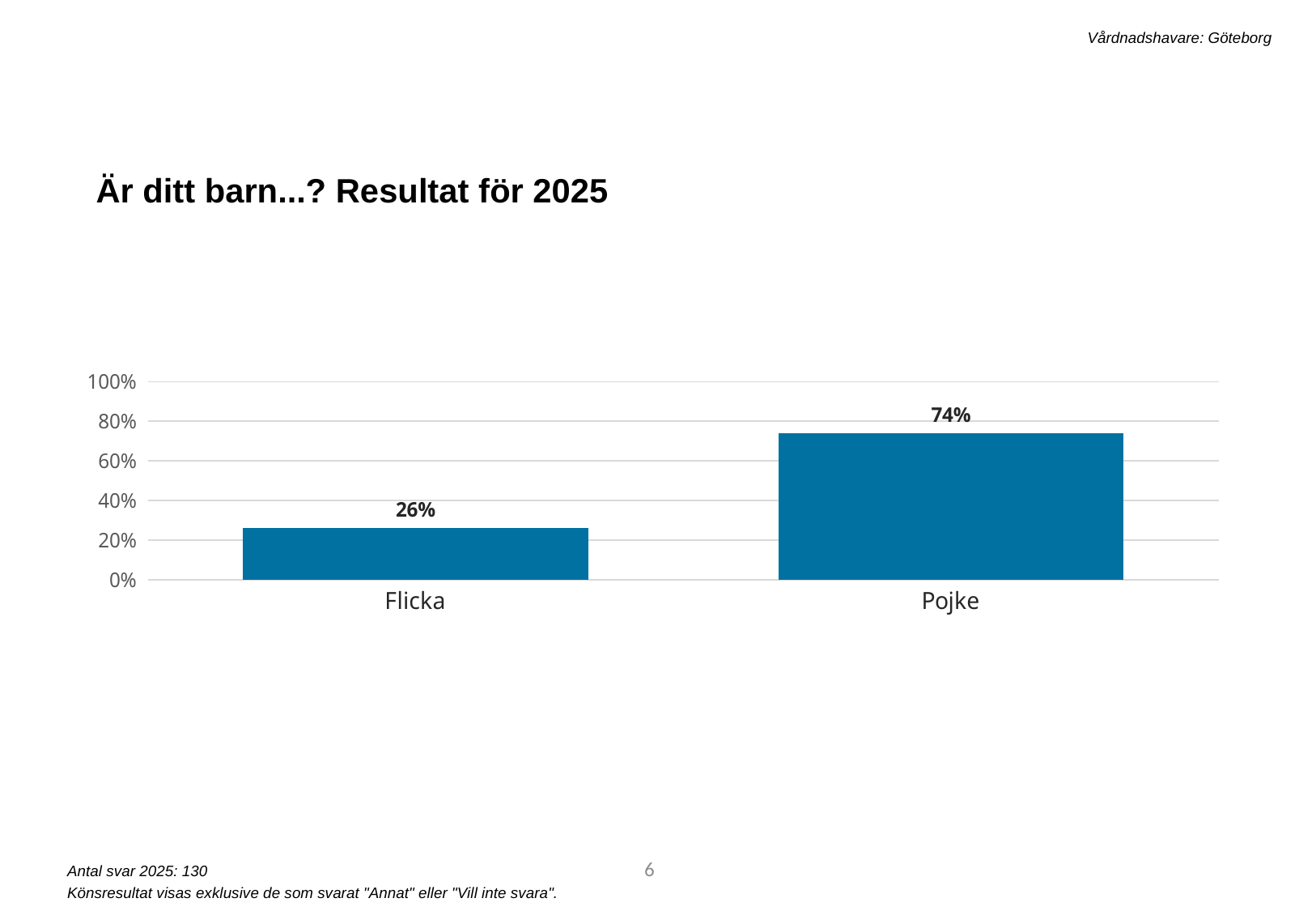
What is the title of the chart? Är ditt barn...? Resultat för 2025 What is the highest value shown on the y axis? 100% Is the value for Flicka greater or less than 40%? less What kind of chart is shown on the slide? bar chart What is the value for Flicka? 26% How many categories are shown on the x axis? 2 What is the difference between the values for Pojke and Flicka? 48% Which is larger, the value for Flicka or the value for Pojke? Pojke Which category has the lowest value? Flicka Is the value for Pojke greater or less than 60%? greater What is the value for Pojke? 74% Which category has the highest value? Pojke